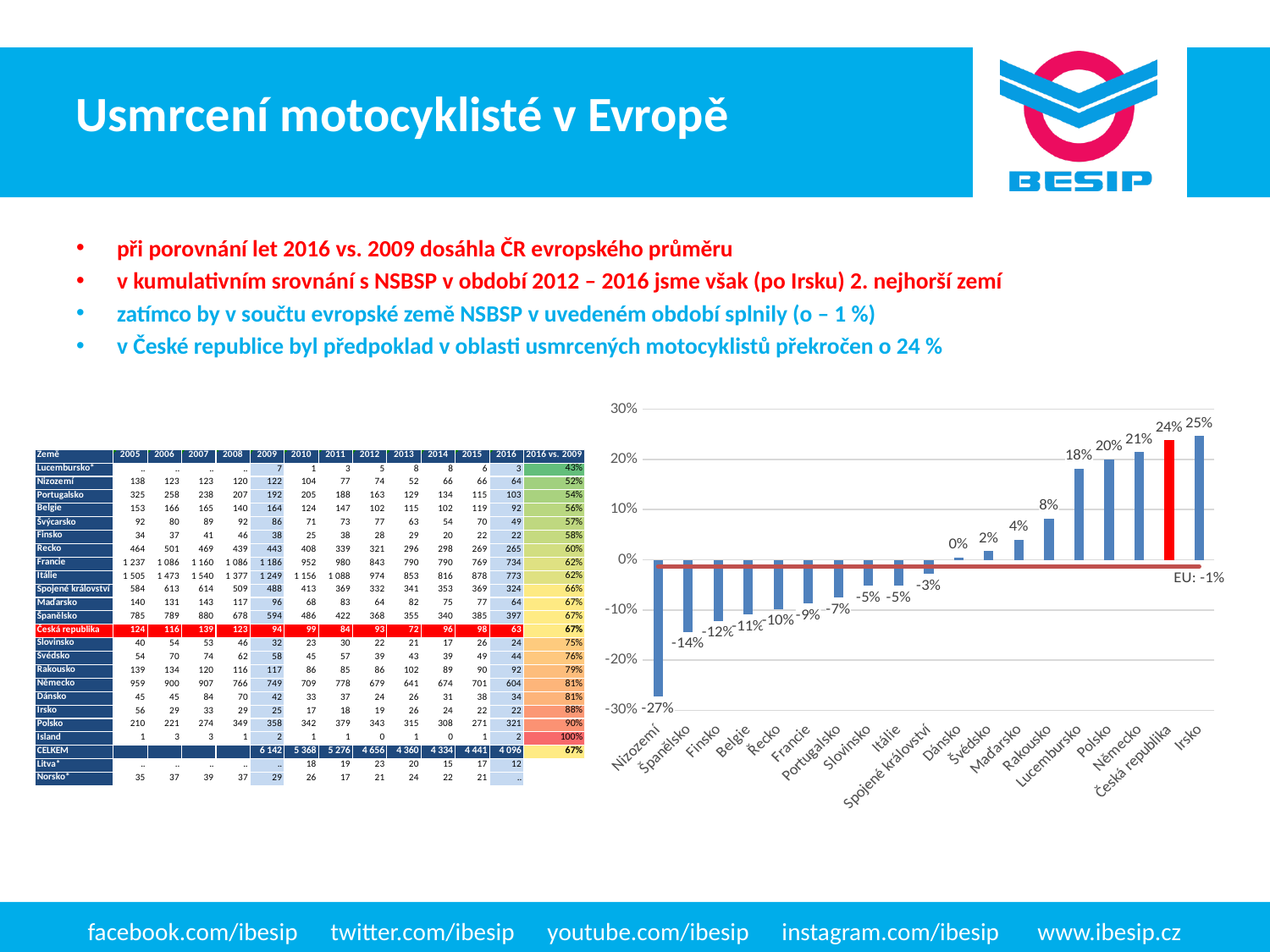
In the bar chart, which country has the highest value? Irsko How many countries are shown in the bar chart? 19 In the bar chart, what is the value for Nizozemí? -27% In the bar chart, which country's bar is coloured red? Česká republika In the bar chart, what is the value for Česká republika? 24% In the bar chart, which is larger, the value for Polsko or the value for Rakousko? Polsko In the bar chart, what is the difference between the values for Irsko and Česká republika? 1% In the bar chart, what is the value for Irsko? 25% In the bar chart, which country has the lowest value? Nizozemí What kind of chart is shown on the right side of the slide? bar chart In the bar chart, what is the value for Lucembursko? 18% In the bar chart, what EU value is marked by the horizontal line? EU: -1%